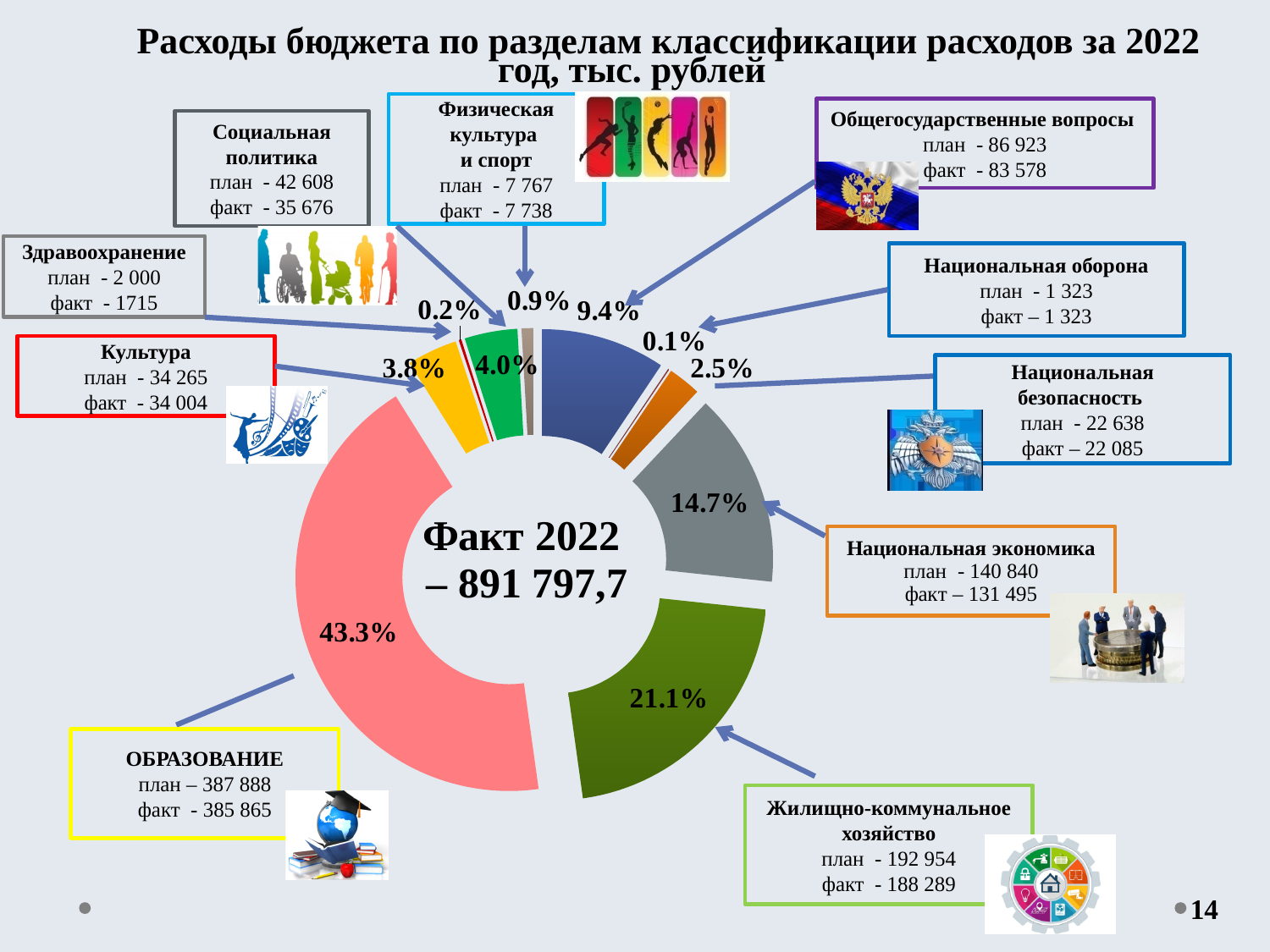
What share of the chart does the largest slice (Образование) represent? 43.3% What is the fact value shown for Национальная экономика? 131 495 What kind of chart is shown on the slide? doughnut (pie) chart What is the difference in percentage points between the Образование slice (43.3%) and the Жилищно-коммунальное хозяйство slice (21.1%)? 22.2 percentage points What total value is printed in the centre of the chart for Факт 2022? 891 797,7 Which section has the smallest share of the chart? Национальная оборона (0.1%) What percentage is labelled on the slice for Национальная экономика? 14.7% What is the title of the chart on the slide? Расходы бюджета по разделам классификации расходов за 2022 год, тыс. рублей How many slices does the doughnut chart have? 10 What percentage is labelled on the slice for Жилищно-коммунальное хозяйство? 21.1% Which section has the largest share of the chart? Образование Which slice is larger: Общегосударственные вопросы or Социальная политика? Общегосударственные вопросы